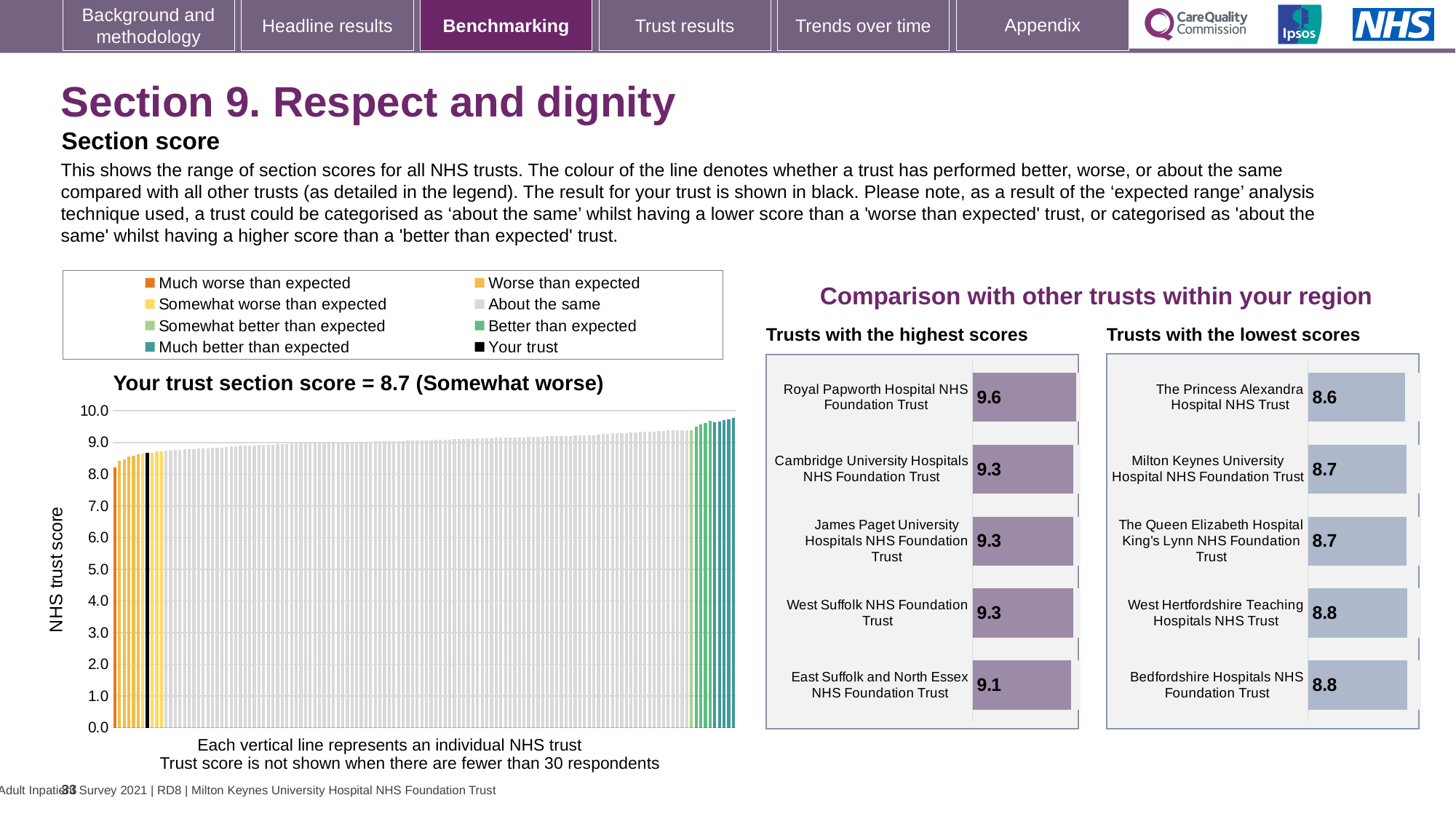
In the 'Your trust section score' chart, what is the section score for your trust? 8.7 In the 'Trusts with the highest scores' chart, what is the difference between the scores of Royal Papworth Hospital NHS Foundation Trust and East Suffolk and North Essex NHS Foundation Trust? 0.5 In the 'Trusts with the highest scores' chart, what is the score for Royal Papworth Hospital NHS Foundation Trust? 9.6 In the 'Trusts with the lowest scores' chart, what is the score for The Princess Alexandra Hospital NHS Trust? 8.6 Which has a higher score: Cambridge University Hospitals NHS Foundation Trust in the 'highest scores' chart or Milton Keynes University Hospital NHS Foundation Trust in the 'lowest scores' chart? Cambridge University Hospitals NHS Foundation Trust In the 'Trusts with the highest scores' chart, what is the score for East Suffolk and North Essex NHS Foundation Trust? 9.1 How many entries does the legend above the 'Your trust section score' chart list? 8 In the 'Trusts with the highest scores' chart, which trust has the highest score? Royal Papworth Hospital NHS Foundation Trust In the 'Trusts with the lowest scores' chart, what is the score for West Hertfordshire Teaching Hospitals NHS Trust? 8.8 In the 'Trusts with the lowest scores' chart, which trust has the lowest score? The Princess Alexandra Hospital NHS Trust In the 'Your trust section score' chart, do the trust scores rise or fall from left to right along the x axis? rise In the 'Trusts with the lowest scores' chart, how many trusts are shown? 5